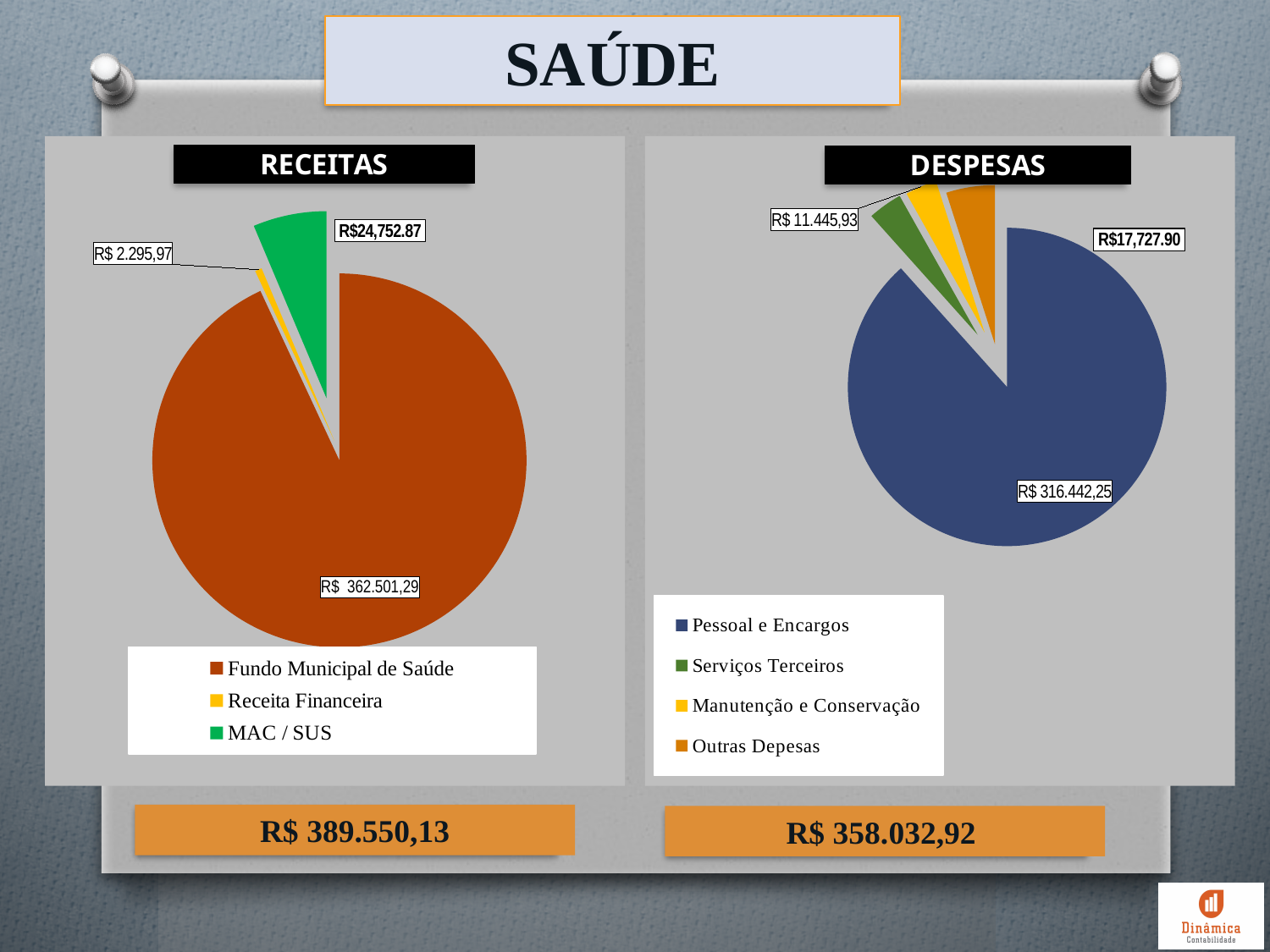
In the RECEITAS chart, what is the value for MAC / SUS? R$24,752.87 In the RECEITAS chart, what is the value for Fundo Municipal de Saúde? R$ 362.501,29 In the RECEITAS chart, what is the difference between Fundo Municipal de Saúde and MAC / SUS? R$ 337.748,42 In the DESPESAS chart, which is larger: Pessoal e Encargos or Outras Despesas? Pessoal e Encargos In the DESPESAS chart, how many slices does the pie have? 4 In the RECEITAS chart, how many categories does the legend list? 3 In the RECEITAS chart, which category has the smallest slice? Receita Financeira What type of chart is the RECEITAS chart? Pie chart In the RECEITAS chart, what is the value for Receita Financeira? R$ 2.295,97 In the DESPESAS chart, which category has the largest slice? Pessoal e Encargos In the DESPESAS chart, what is the value for Pessoal e Encargos? R$ 316.442,25